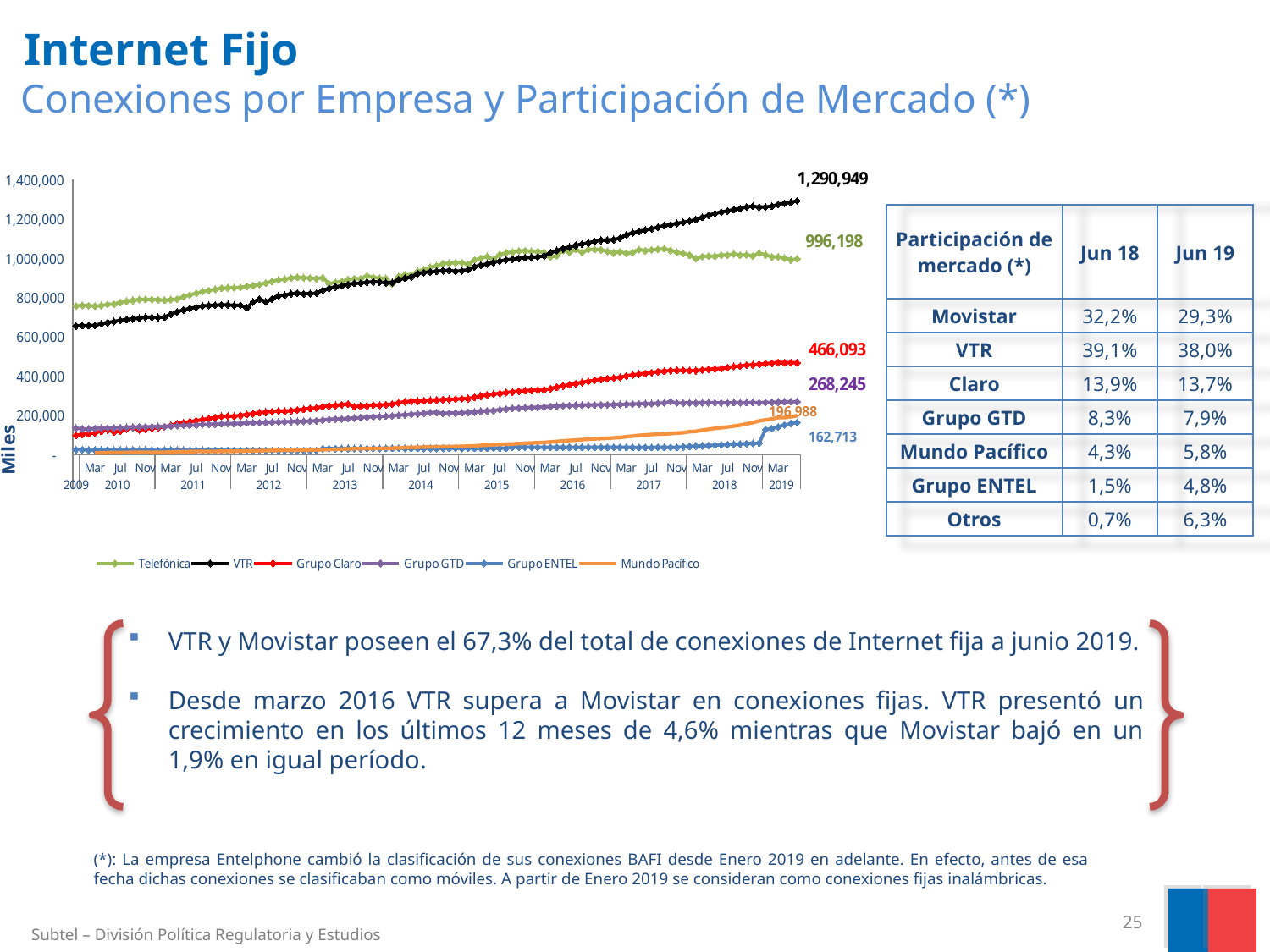
What is the latest value labelled for Telefónica on the chart? 996,198 Which series has the highest value at the end of the chart (2019)? VTR What is the latest value labelled for Grupo Claro on the chart? 466,093 Is the value for VTR at the start of the chart in 2009 greater or less than 800,000? less What is the latest value labelled for VTR on the chart? 1,290,949 What kind of chart is shown on the slide? line chart What is the difference between the final labelled values of VTR and Telefónica? 294,751 Which is larger at the end of the chart, Grupo Claro or Grupo GTD? Grupo Claro Which series has the lowest value at the end of the chart (2019)? Grupo ENTEL Does the VTR line rise or fall from 2009 to 2019? rise What is the latest value labelled for Grupo GTD on the chart? 268,245 How many series does the chart legend list? 6